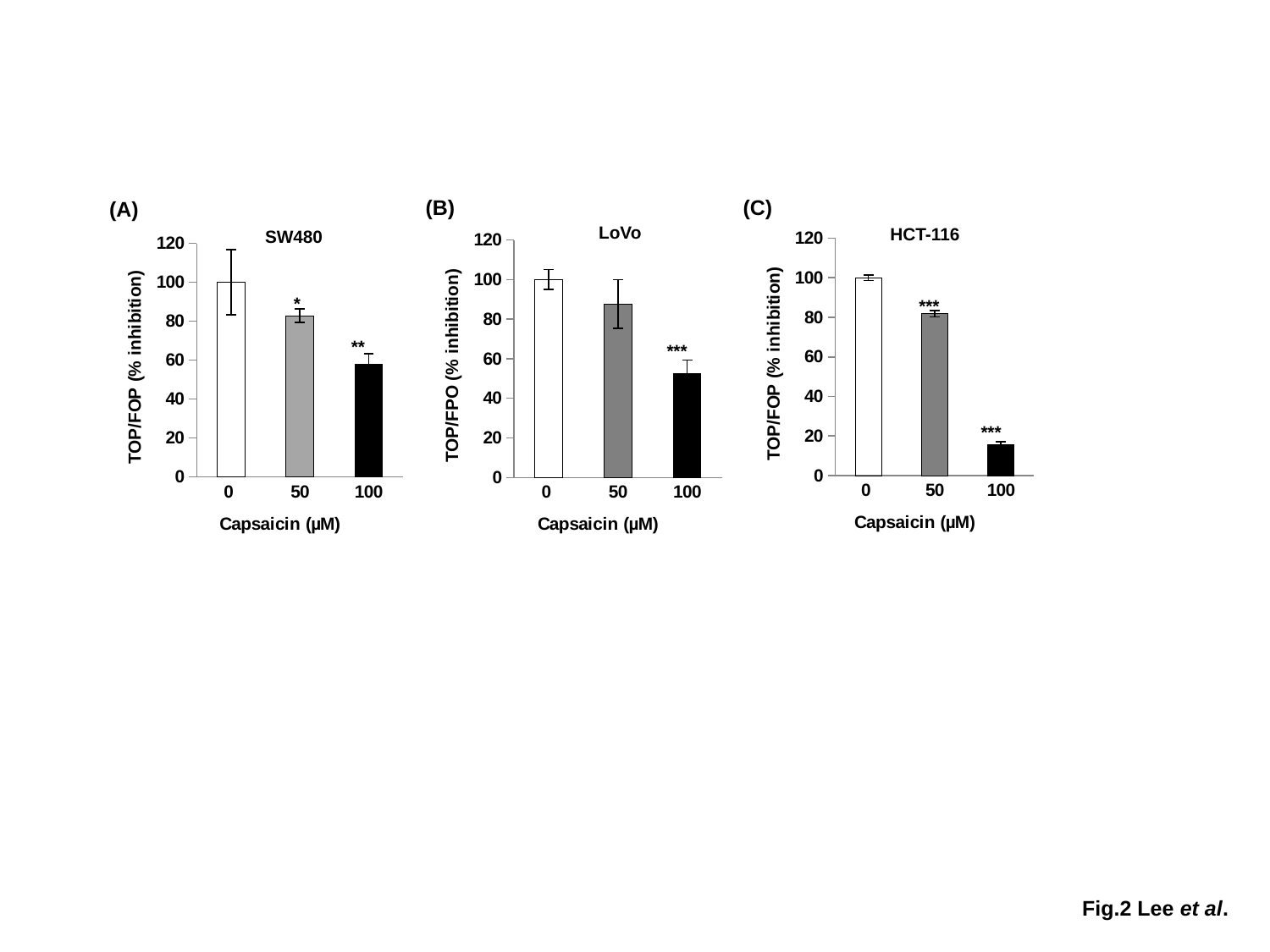
In the SW480 chart, do the TOP/FOP values rise or fall as the capsaicin concentration increases? fall What is the x-axis label of the LoVo chart? Capsaicin (µM) In the LoVo chart, is the value for 50 µM capsaicin greater or less than 80? greater In the HCT-116 chart, which is larger, the value for 50 µM or the value for 100 µM capsaicin? 50 How many capsaicin concentrations are shown on the x axis of the LoVo chart? 3 What is the title of the chart labelled (C)? HCT-116 What kind of chart is the SW480 chart? bar chart In the HCT-116 chart, is the value for 100 µM capsaicin greater or less than 20? less In the LoVo chart, is the value for 100 µM capsaicin greater or less than 60? less In the HCT-116 chart, which capsaicin concentration has the lowest TOP/FOP value? 100 In the SW480 chart, which capsaicin concentration has the highest TOP/FOP value? 0